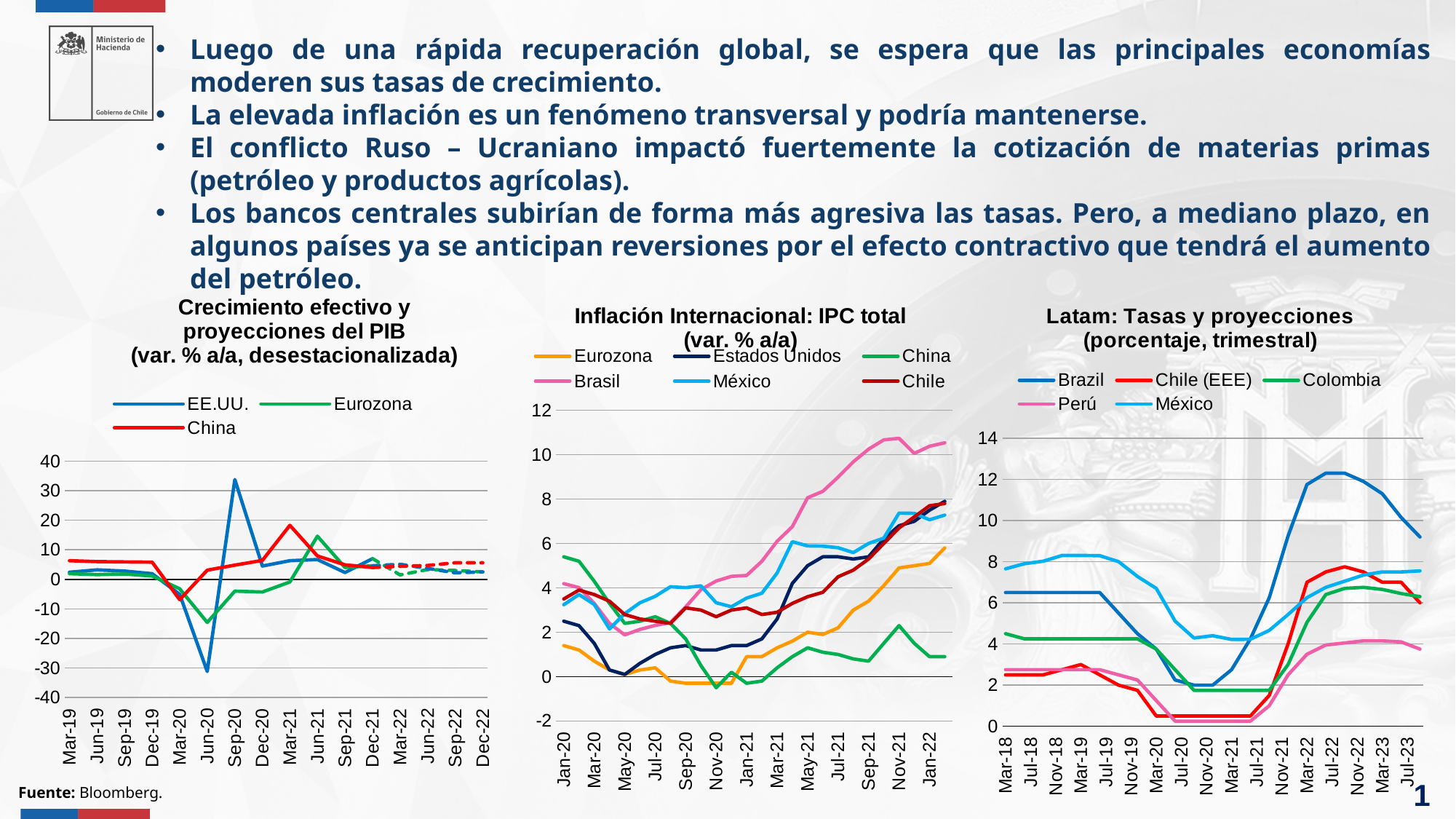
What kind of chart is the 'Crecimiento efectivo y proyecciones del PIB' chart? line chart In the 'Crecimiento efectivo y proyecciones del PIB' chart, which series reaches the highest peak? EE.UU. How many series does the legend of the 'Inflación Internacional: IPC total' chart list? 6 How many series does the legend of the 'Latam: Tasas y proyecciones' chart list? 5 In the 'Inflación Internacional: IPC total' chart, does the Brasil series rise or fall from Jan-20 to Jan-22? rise In the 'Latam: Tasas y proyecciones' chart, is the value for Chile (EEE) at Jul-20 greater or less than 2? less In the 'Crecimiento efectivo y proyecciones del PIB' chart, is the value for EE.UU. at Jun-20 greater or less than -20? less What is the source cited at the bottom of the slide? Bloomberg In the 'Inflación Internacional: IPC total' chart, is the value for Brasil at Nov-21 greater or less than 10? greater In the 'Inflación Internacional: IPC total' chart, which series reaches the highest value? Brasil